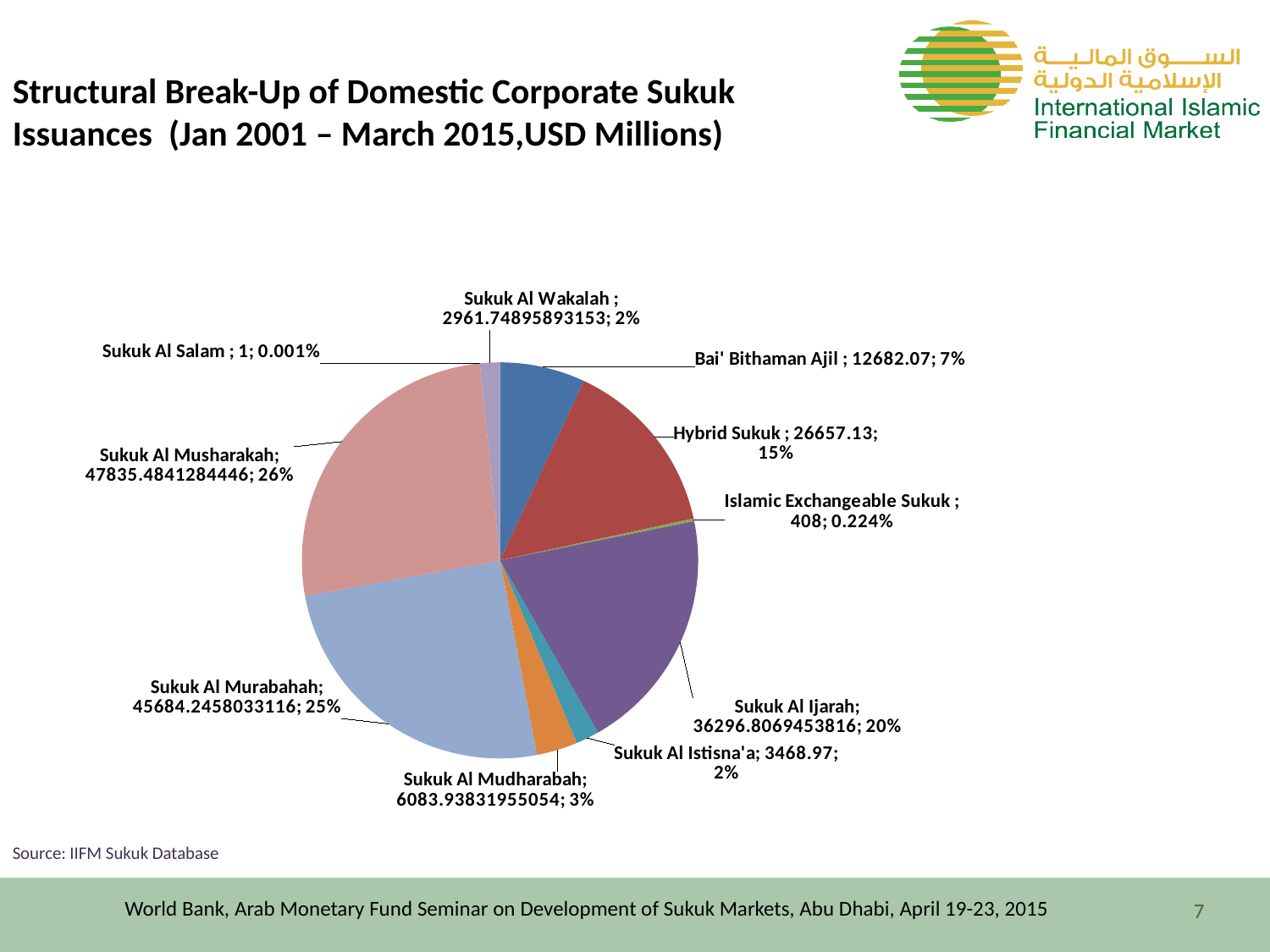
What kind of chart is shown on the slide? Pie chart What share of the pie does Sukuk Al Salam represent? 0.001% How many slices (categories) does the pie chart have? 10 What is the difference between the values for Hybrid Sukuk and Bai' Bithaman Ajil? 13975.06 Which category has the smallest value in the pie chart? Sukuk Al Salam Which category has the largest value in the pie chart? Sukuk Al Musharakah What share of the pie does Sukuk Al Murabahah represent? 25% What is the value shown for Islamic Exchangeable Sukuk? 408 What is the value shown for Sukuk Al Ijarah? 36296.8069453816 What is the value shown for Hybrid Sukuk? 26657.13 Which is larger, the value for Sukuk Al Ijarah or the value for Hybrid Sukuk? Sukuk Al Ijarah What is the source cited below the chart? IIFM Sukuk Database